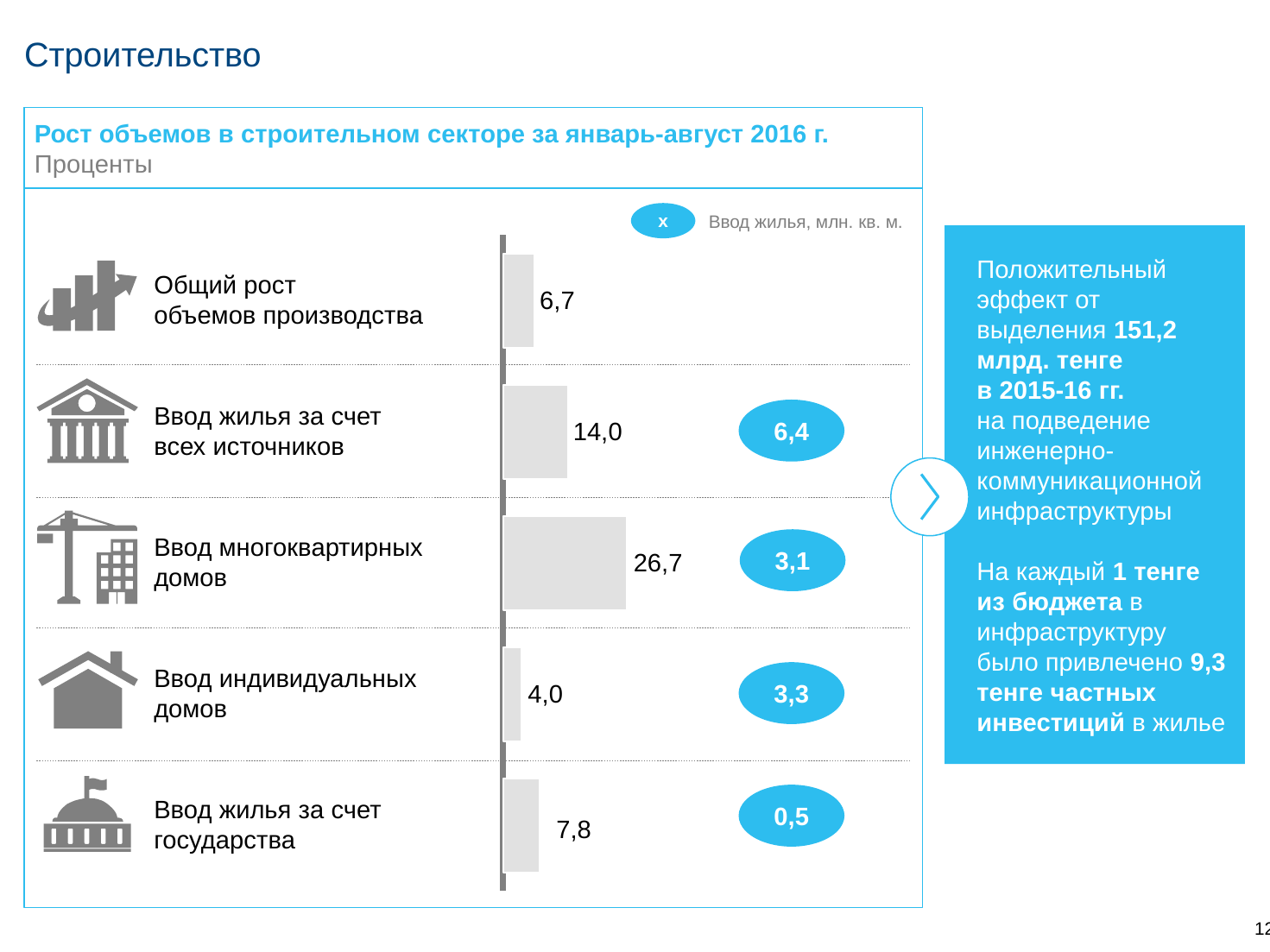
What is the housing commissioning figure (Ввод жилья, млн. кв. м.) shown for "Ввод жилья за счет государства"? 0,5 What is the housing commissioning figure (Ввод жилья, млн. кв. м.) shown for "Ввод индивидуальных домов"? 3,3 Which category has the lowest value? Ввод индивидуальных домов Which category has the highest value? Ввод многоквартирных домов What is the value for "Общий рост объемов производства"? 6,7 What is the value for "Ввод жилья за счет государства"? 7,8 What is the title of the chart? Рост объемов в строительном секторе за январь-август 2016 г. What kind of chart is this? Bar chart What is the value for "Ввод многоквартирных домов"? 26,7 How many categories are shown in the chart? 5 Which is larger: the value for "Ввод жилья за счет государства" or for "Общий рост объемов производства"? Ввод жилья за счет государства What is the difference between the values for "Ввод многоквартирных домов" and "Ввод жилья за счет всех источников"? 12,7